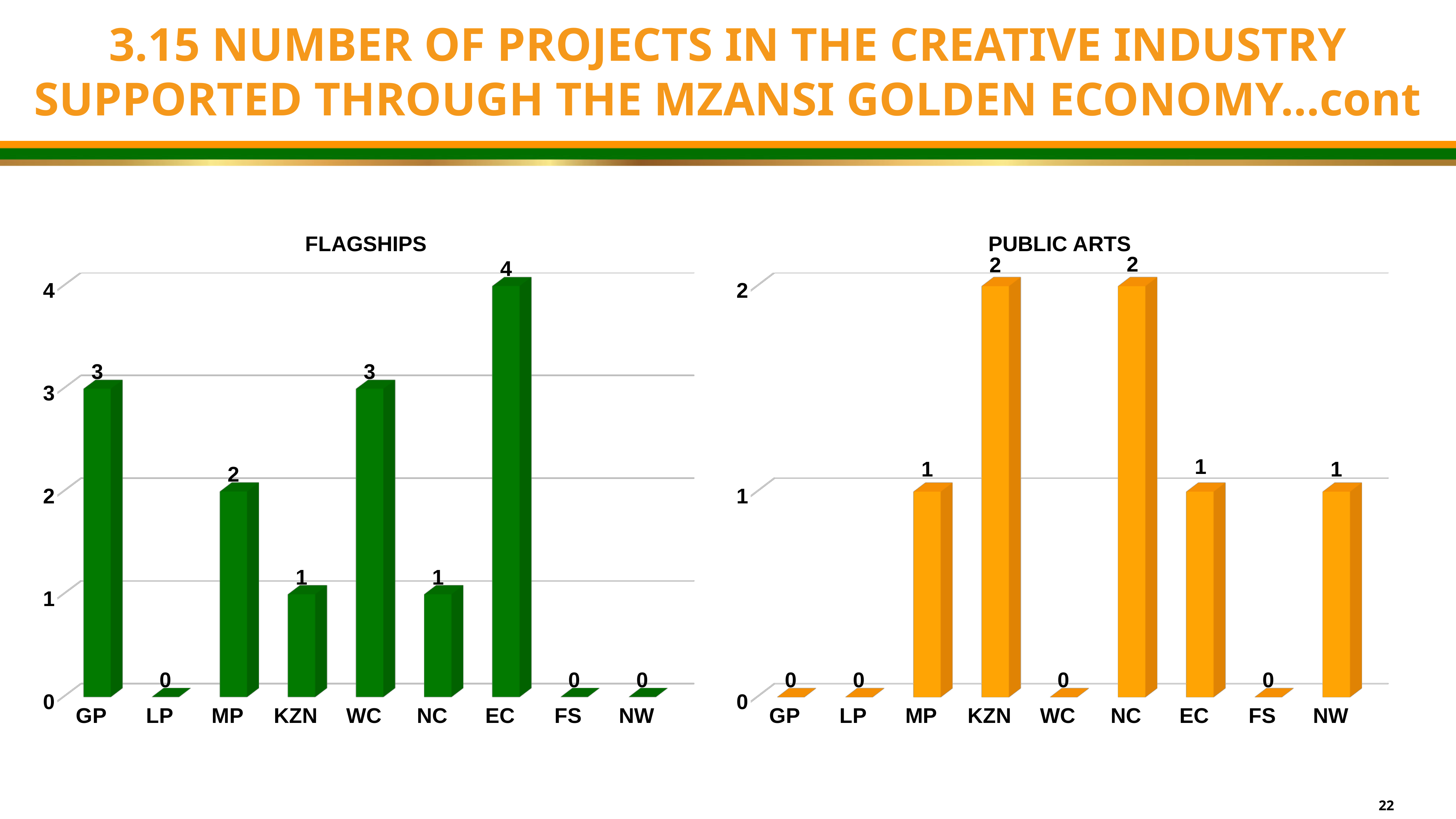
In the PUBLIC ARTS chart, what is the value for KZN? 2 In the FLAGSHIPS chart, how many provinces are shown on the x axis? 9 In the FLAGSHIPS chart, which is larger, the value for WC or the value for KZN? WC In the FLAGSHIPS chart, what is the difference between the values for EC and MP? 2 In the PUBLIC ARTS chart, what is the difference between the values for NC and EC? 1 In the PUBLIC ARTS chart, what is the value for NW? 1 What colour are the bars in the FLAGSHIPS chart? Green In the FLAGSHIPS chart, which province has the highest value? EC In the FLAGSHIPS chart, what is the value for EC? 4 In the PUBLIC ARTS chart, how many provinces have a value of 0? 4 In the FLAGSHIPS chart, what is the value for GP? 3 What kind of chart is the PUBLIC ARTS chart? Bar chart